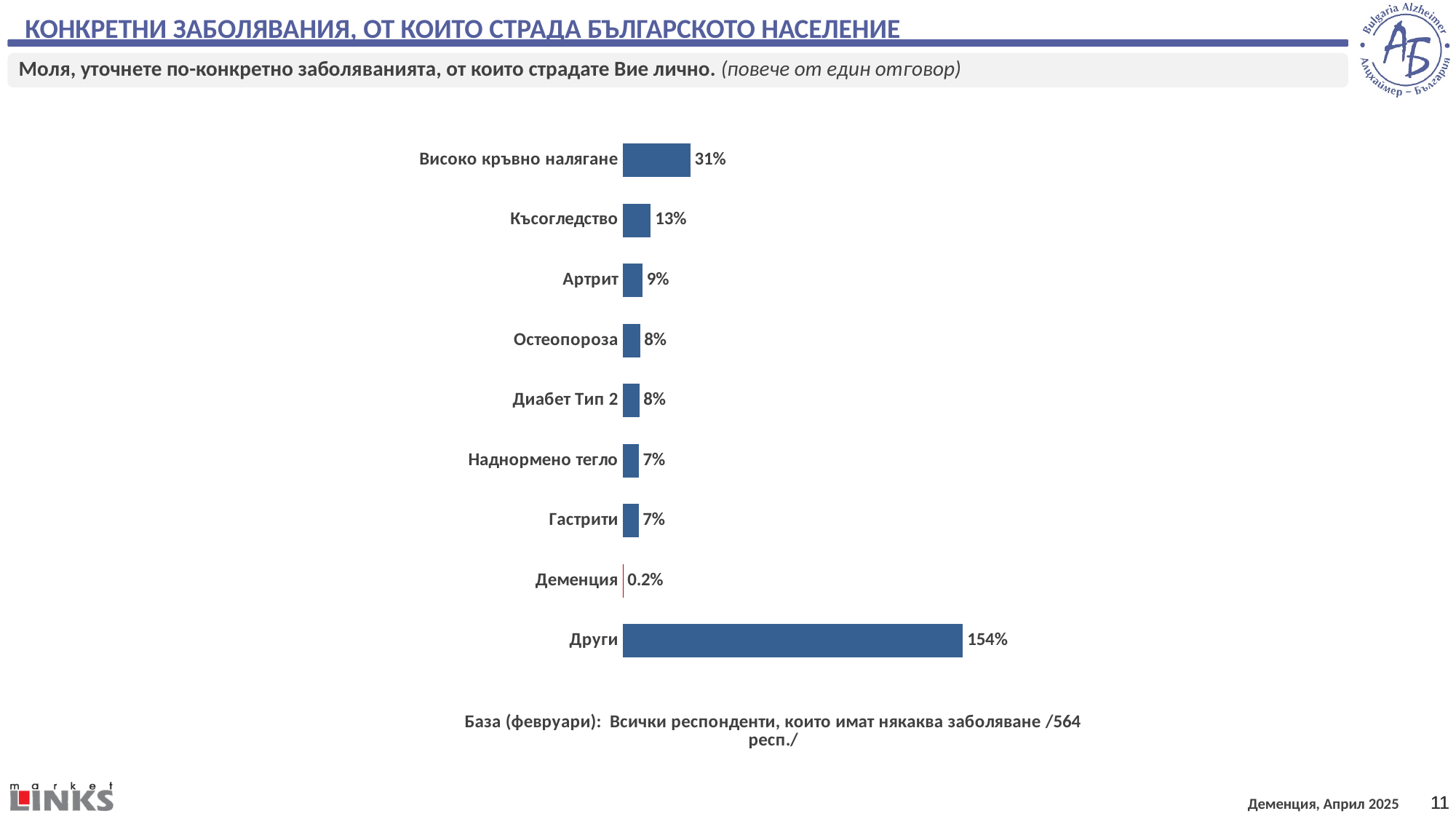
How many categories (diseases) are plotted in the chart? 9 What kind of chart is shown on the slide? Bar chart Which category has the lowest value? Деменция What is the value for Други? 154% Which category has the highest value? Други Which is larger, the value for Остеопороза or the value for Наднормено тегло? Остеопороза What is the value for Деменция? 0.2% What is the value for Високо кръвно налягане? 31% What is the difference between the values for Високо кръвно налягане and Късогледство? 18% What is the base (number of respondents) stated below the chart? 564 респ. What is the value for Късогледство? 13% What is the value for Артрит? 9%